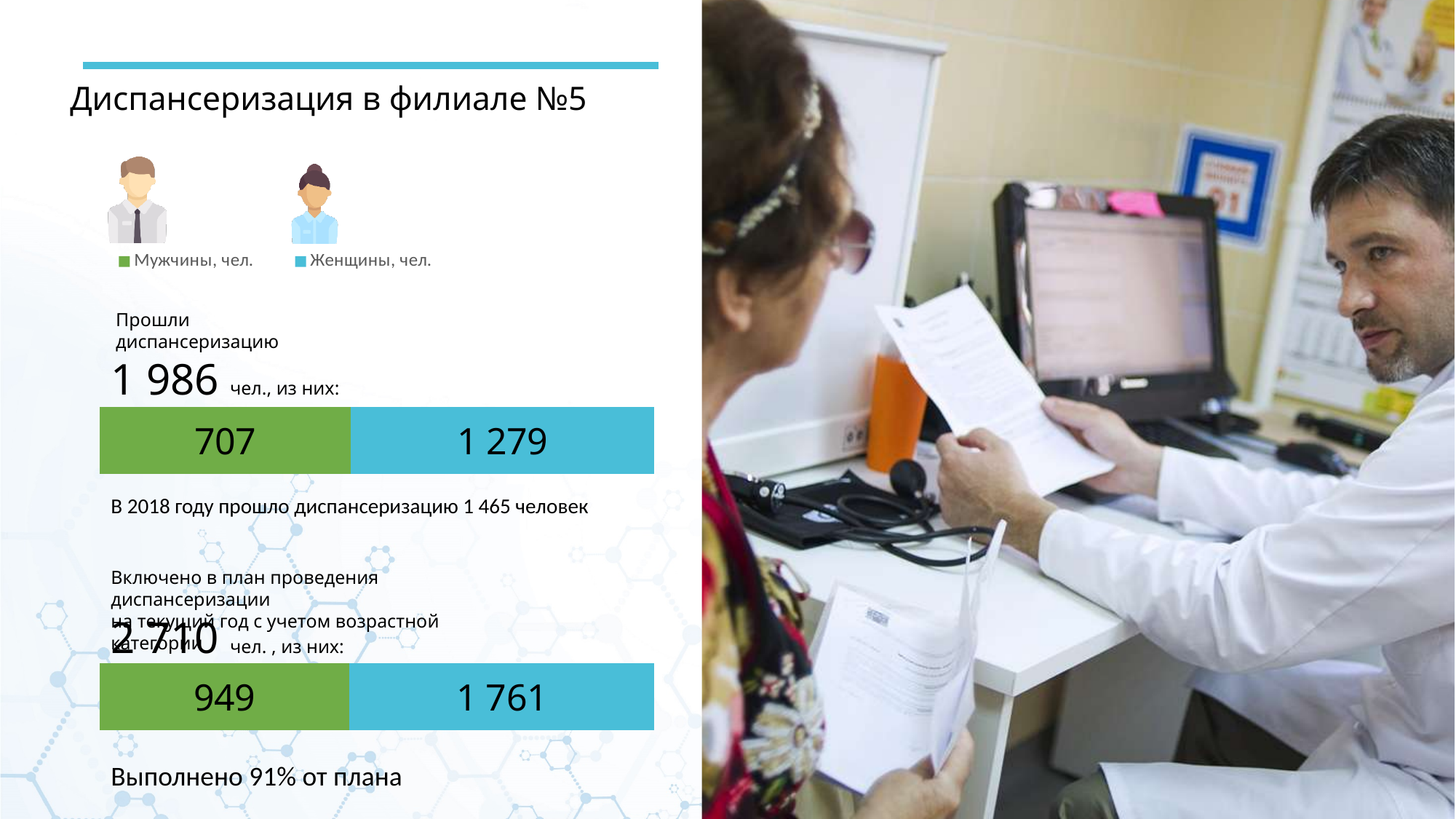
In the lower chart (Включено в план проведения диспансеризации), what is the value for Женщины? 1 761 In the lower chart, which group has the smaller value? Мужчины In the upper chart (Прошли диспансеризацию), what is the value for Мужчины? 707 In the lower chart, what is the difference between the Женщины and Мужчины values? 812 How many series does the legend list? 2 In the upper chart, what is the difference between the Женщины and Мужчины values? 572 In the upper chart, which group is larger, Мужчины or Женщины? Женщины What is the total of the upper stacked bar (Прошли диспансеризацию)? 1 986 What colour represents Мужчины in the charts? Green In the lower chart (Включено в план проведения диспансеризации), what is the value for Мужчины? 949 In the upper chart (Прошли диспансеризацию), what is the value for Женщины? 1 279 What is the total of the lower stacked bar (Включено в план)? 2 710